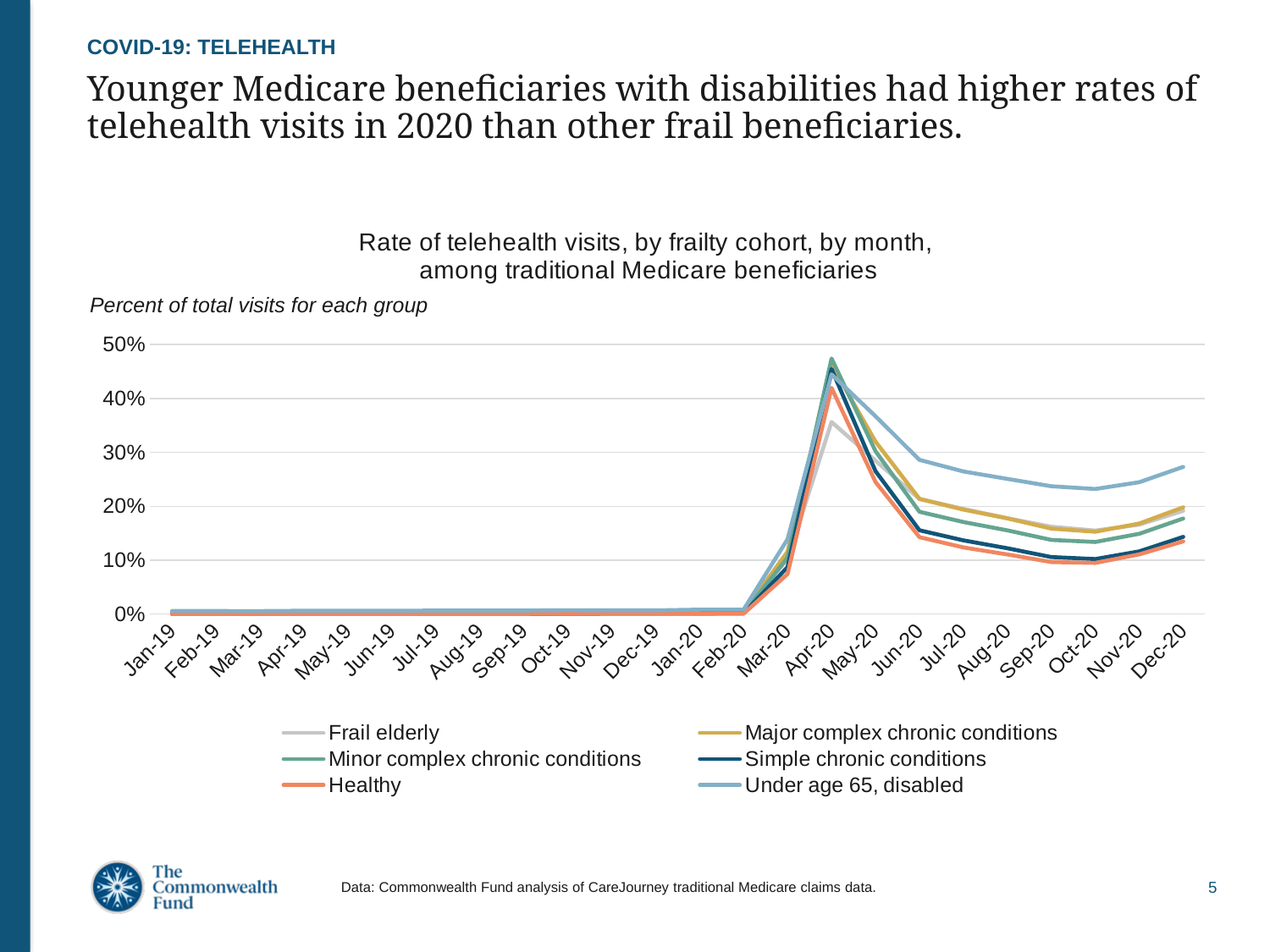
How many months are shown along the x axis? 24 Is the value for Frail elderly in Apr-20 greater or less than 40%? less In which month do all the series reach their peak? Apr-20 Which cohort has the highest rate of telehealth visits in Dec-20? Under age 65, disabled Which cohort has the lowest rate of telehealth visits in Apr-20? Frail elderly What kind of chart is shown on the slide? Line chart Is the value for Healthy in Dec-20 greater or less than 20%? less What is the title of the chart? Rate of telehealth visits, by frailty cohort, by month, among traditional Medicare beneficiaries Do the values rise or fall from Apr-20 to Oct-20? fall Is the value for Under age 65, disabled in Dec-20 greater or less than 20%? greater In Dec-20, which is larger: the value for Under age 65, disabled or the value for Healthy? Under age 65, disabled How many series does the legend list? 6